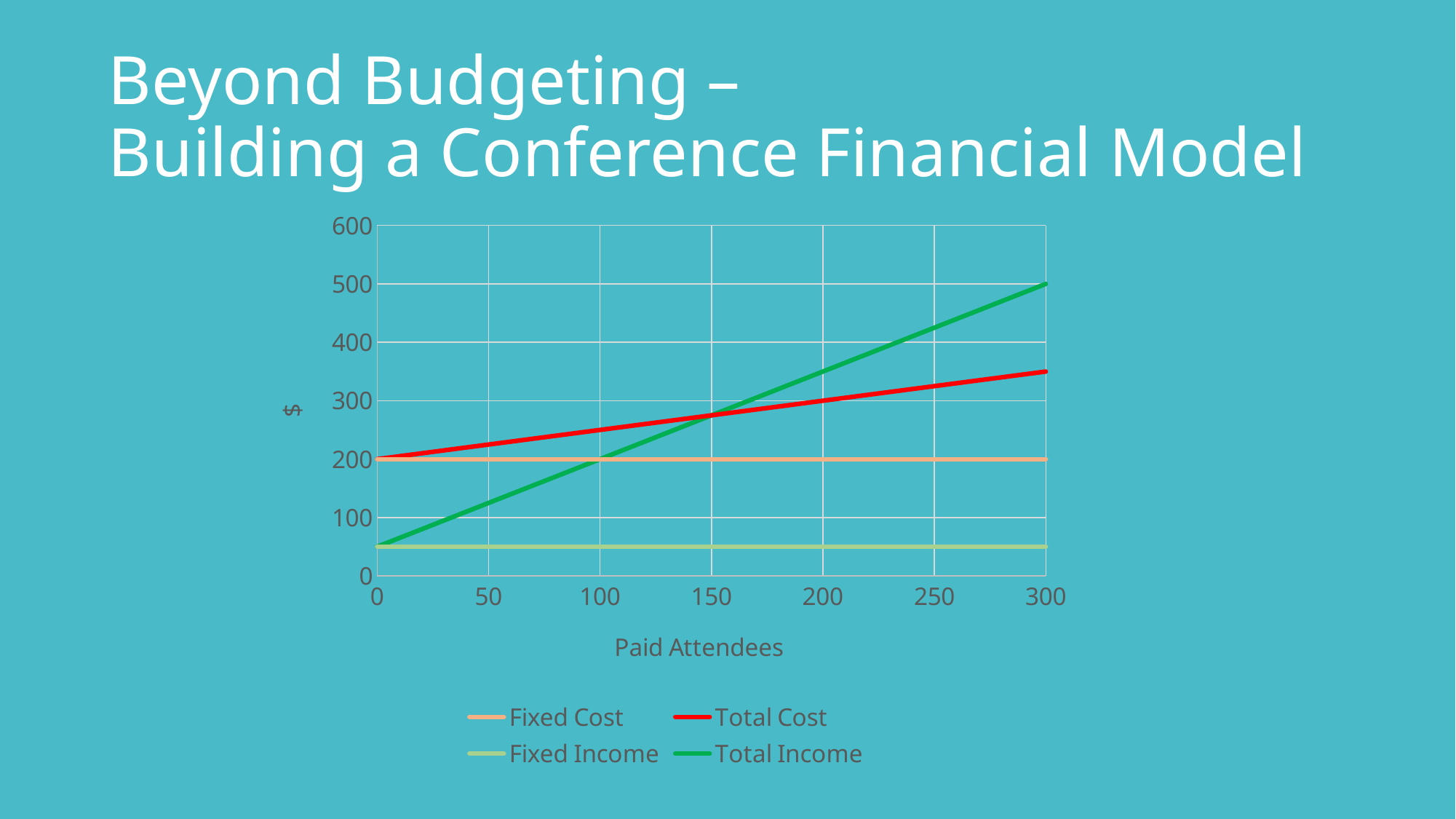
What kind of chart is shown on the slide? line chart Does the Total Income line rise or fall as the number of paid attendees increases? rise What is the label on the x axis of the chart? Paid Attendees How many series does the legend list? 4 What is the label on the y axis of the chart? $ What is the value of the Fixed Cost line? 200 At 300 paid attendees, which is larger: Total Income or Total Cost? Total Income What is the value of Total Income at 300 paid attendees? 500 Is the value of the Fixed Income line greater or less than 100? less Is the value of Total Cost at 300 paid attendees greater or less than 300? greater At 0 paid attendees, which is larger: Total Cost or Total Income? Total Cost What is the value of Total Cost at 0 paid attendees? 200